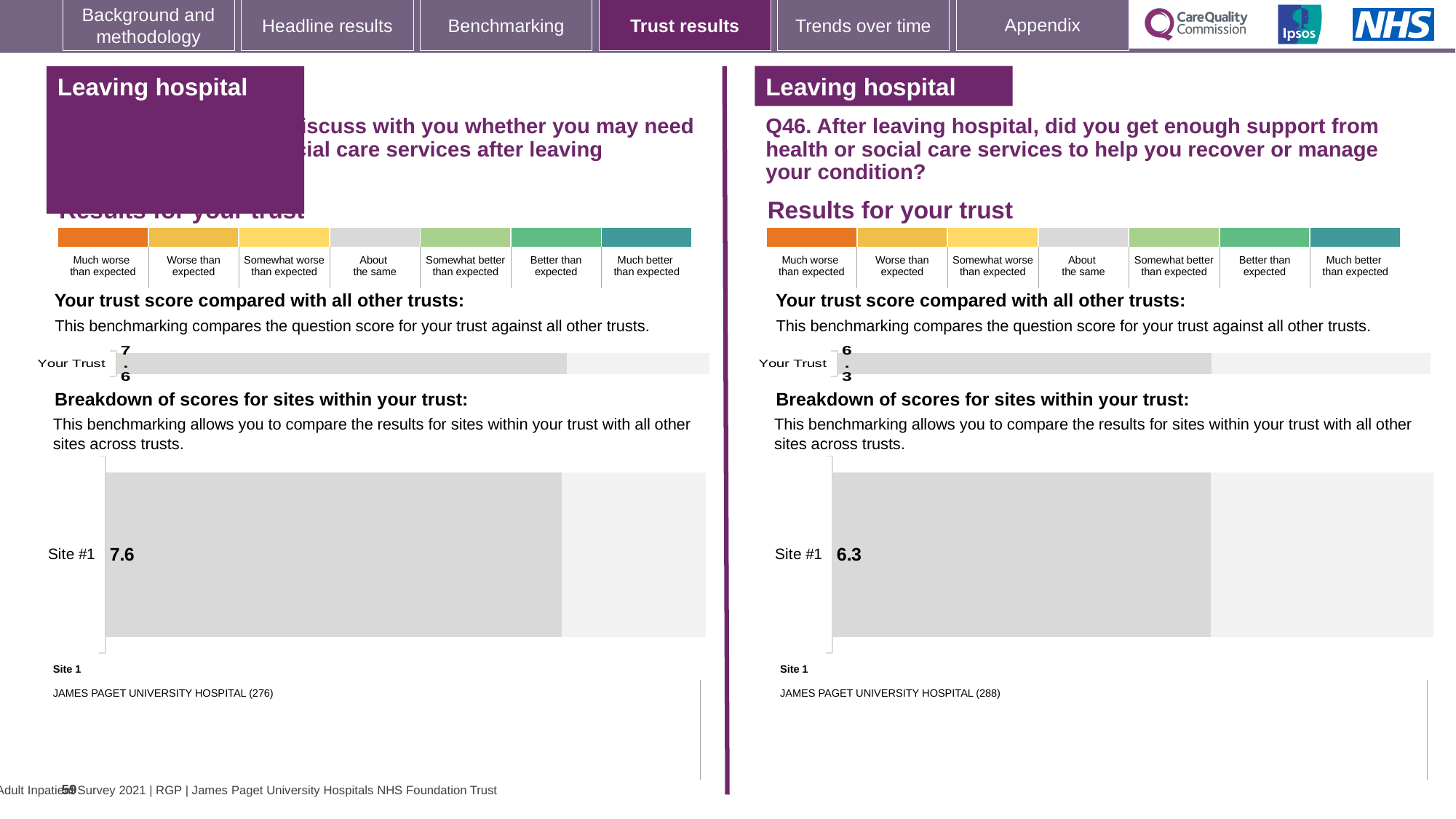
On the right half of the slide (Q46), what score is shown for Site #1 in the breakdown of scores chart? 6.3 What kind of chart is used to show the Site #1 score in the breakdown of scores section on the right half of the slide? bar chart Which half of the slide shows the higher 'Your Trust' score, the left or the right (Q46)? left On the left half of the slide, what score is shown for Site #1 in the breakdown of scores chart? 7.6 On the left half of the slide, what number in brackets is shown next to the Site 1 hospital name below the breakdown chart? 276 On the right half of the slide (Q46), which hospital is listed as Site 1 below the breakdown chart? JAMES PAGET UNIVERSITY HOSPITAL On the left half of the slide, what is the 'Your Trust' score shown in the trust benchmarking bar chart? 7.6 On the right half of the slide (Q46), what is the 'Your Trust' score shown in the trust benchmarking bar chart? 6.3 How many sites are shown in the breakdown of scores chart on the left half of the slide? 1 What is the difference between the Site #1 score on the left half of the slide and the Site #1 score on the right half (Q46)? 1.3